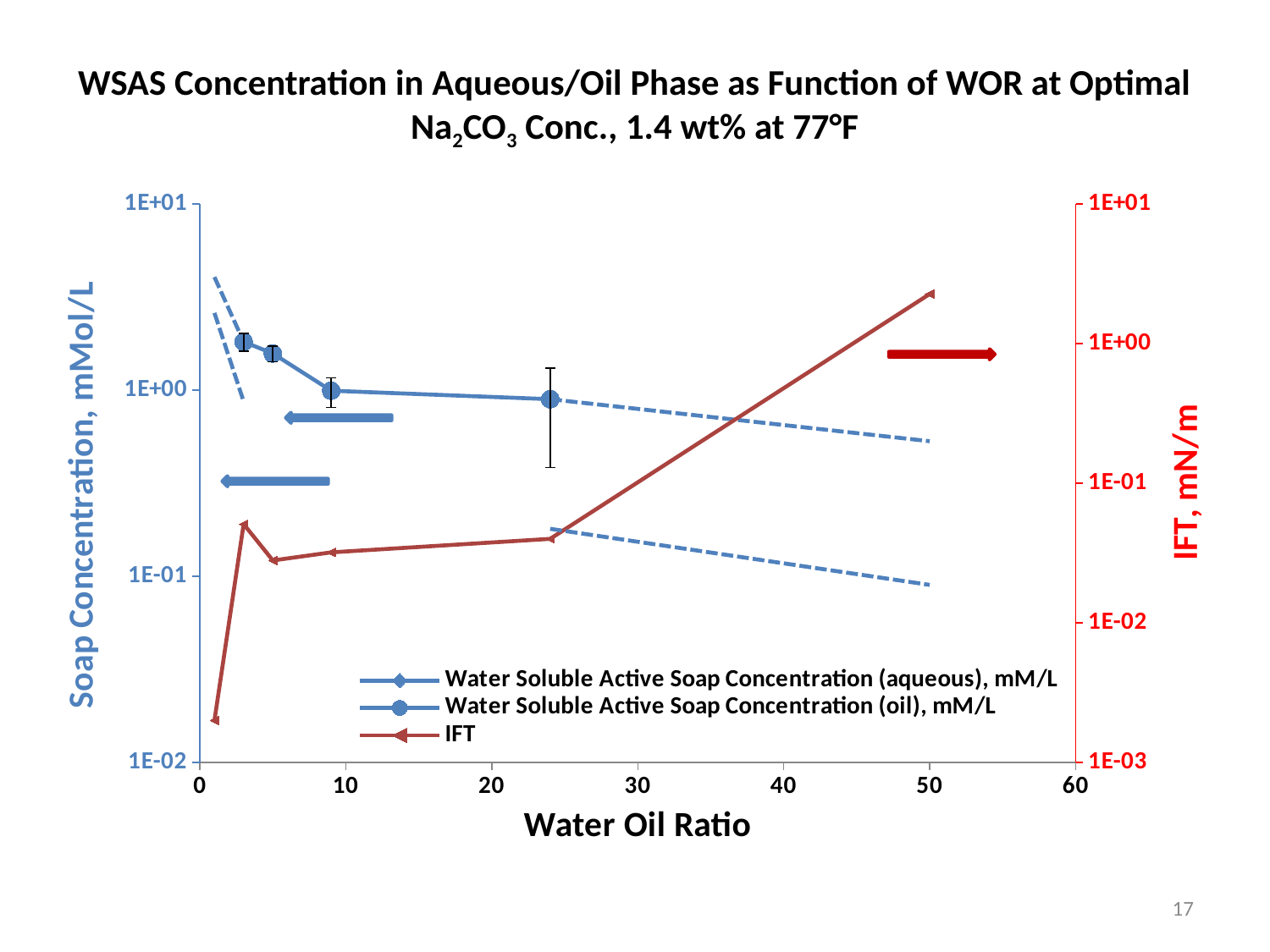
Does the IFT series rise or fall overall as the Water Oil Ratio increases from 1 to 50? rise Is the IFT value at a Water Oil Ratio of 1 greater or less than 1E-02 mN/m? less How many series does the legend list? 3 What kind of chart is shown on the slide? line chart What is the title of the right-hand y axis? IFT, mN/m Is the Water Soluble Active Soap Concentration (oil) at a Water Oil Ratio of 3 greater or less than 1E+00 mMol/L? greater At which Water Oil Ratio does the IFT series have its lowest value? 1 Does the Water Soluble Active Soap Concentration (oil) series rise or fall as the Water Oil Ratio increases? fall Is the IFT value at a Water Oil Ratio of 50 greater or less than 1E+00 mN/m? greater What is the title of the x axis? Water Oil Ratio At which Water Oil Ratio does the IFT series reach its highest value? 50 How many data points are plotted for the Water Soluble Active Soap Concentration (oil) series? 4